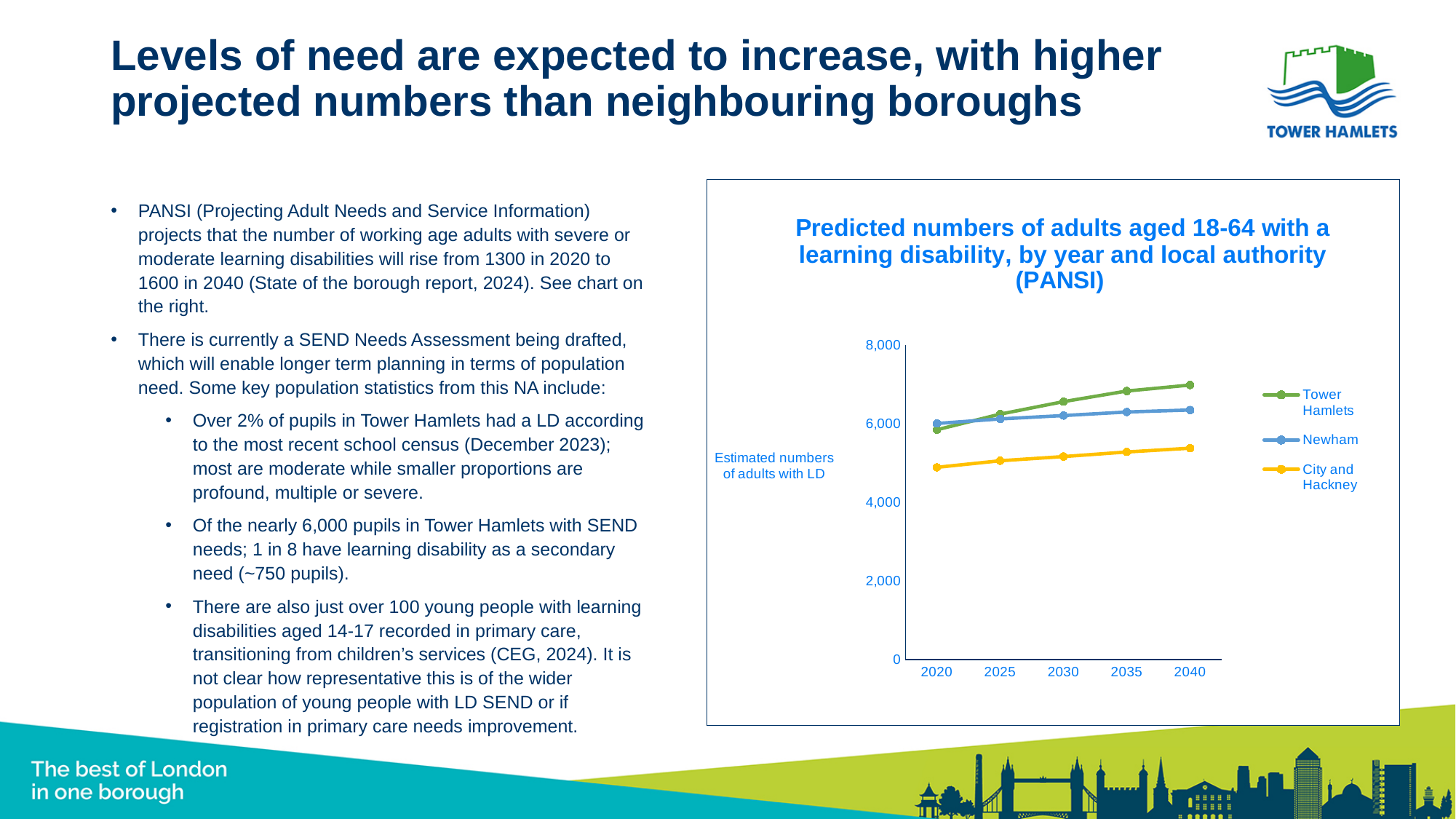
What kind of chart is shown on the slide? Line chart Which local authority has the lowest predicted number of adults with a learning disability in 2040? City and Hackney Is the value for Newham in 2020 greater or less than 4,000? greater Is the value for Tower Hamlets in 2040 greater or less than 6,000? greater Which series is drawn in green on the chart? Tower Hamlets How many years are plotted along the x axis of the chart? 5 How many series does the chart's legend list? 3 In 2040, which is larger: the value for Tower Hamlets or the value for Newham? Tower Hamlets Does the Tower Hamlets line rise or fall from 2020 to 2040? Rises Which local authority has the highest predicted number of adults with a learning disability in 2040? Tower Hamlets Is the value for City and Hackney in 2040 greater or less than 6,000? less Which local authority has the lowest predicted number of adults with a learning disability in 2020? City and Hackney